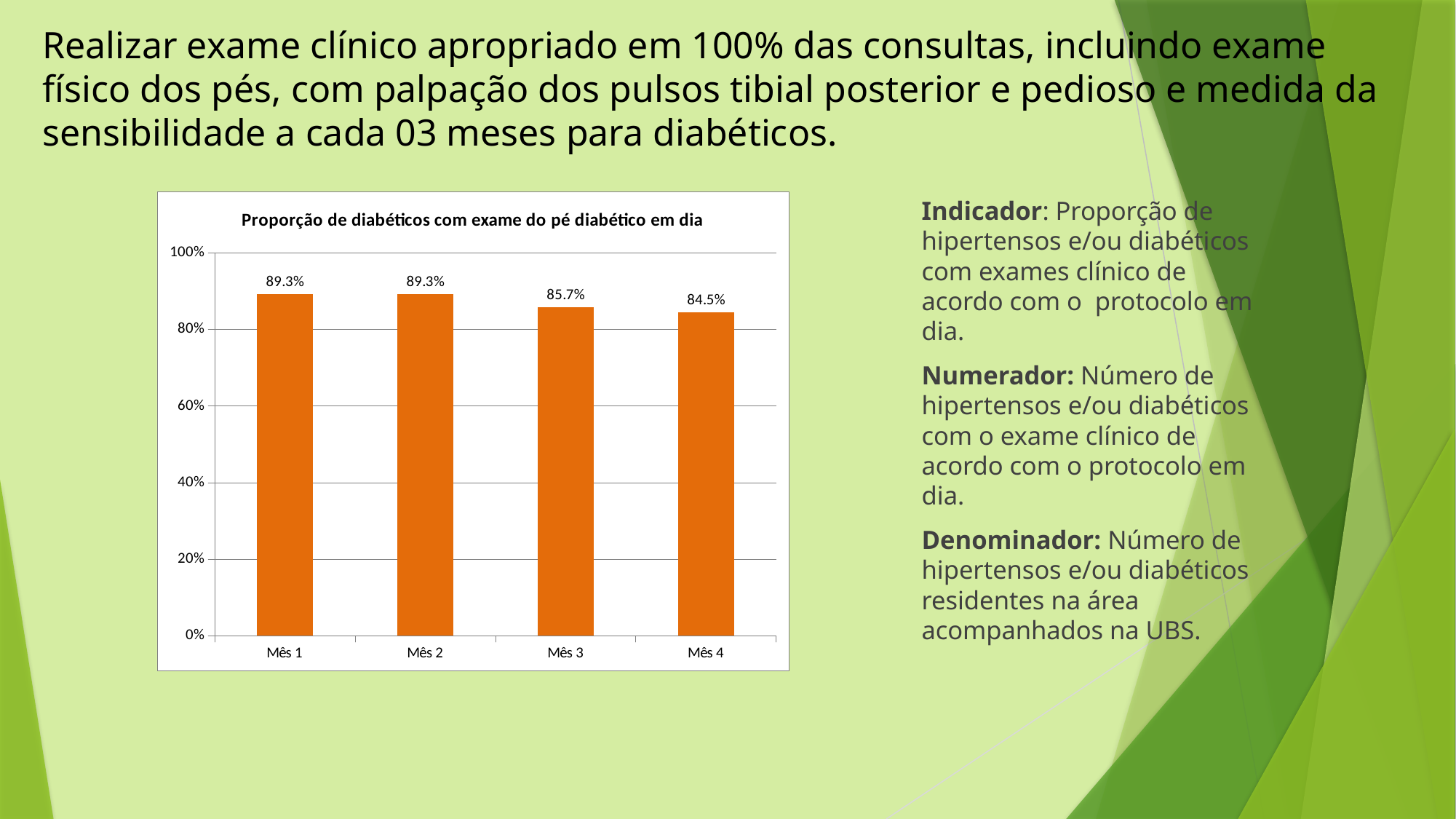
What is the value for Mês 1? 89.3% Is the value for Mês 4 greater or less than 80%? greater What kind of chart is shown? bar chart Which is larger, the value for Mês 2 or the value for Mês 3? Mês 2 What is the value for Mês 4? 84.5% Which month has the lowest value? Mês 4 How many months are shown on the x axis? 4 What is the difference between the values for Mês 1 and Mês 4? 4.8% What is the title of the chart? Proporção de diabéticos com exame do pé diabético em dia Do the values rise or fall from Mês 2 to Mês 4? fall What is the difference between the values for Mês 3 and Mês 4? 1.2% What is the value for Mês 3? 85.7%